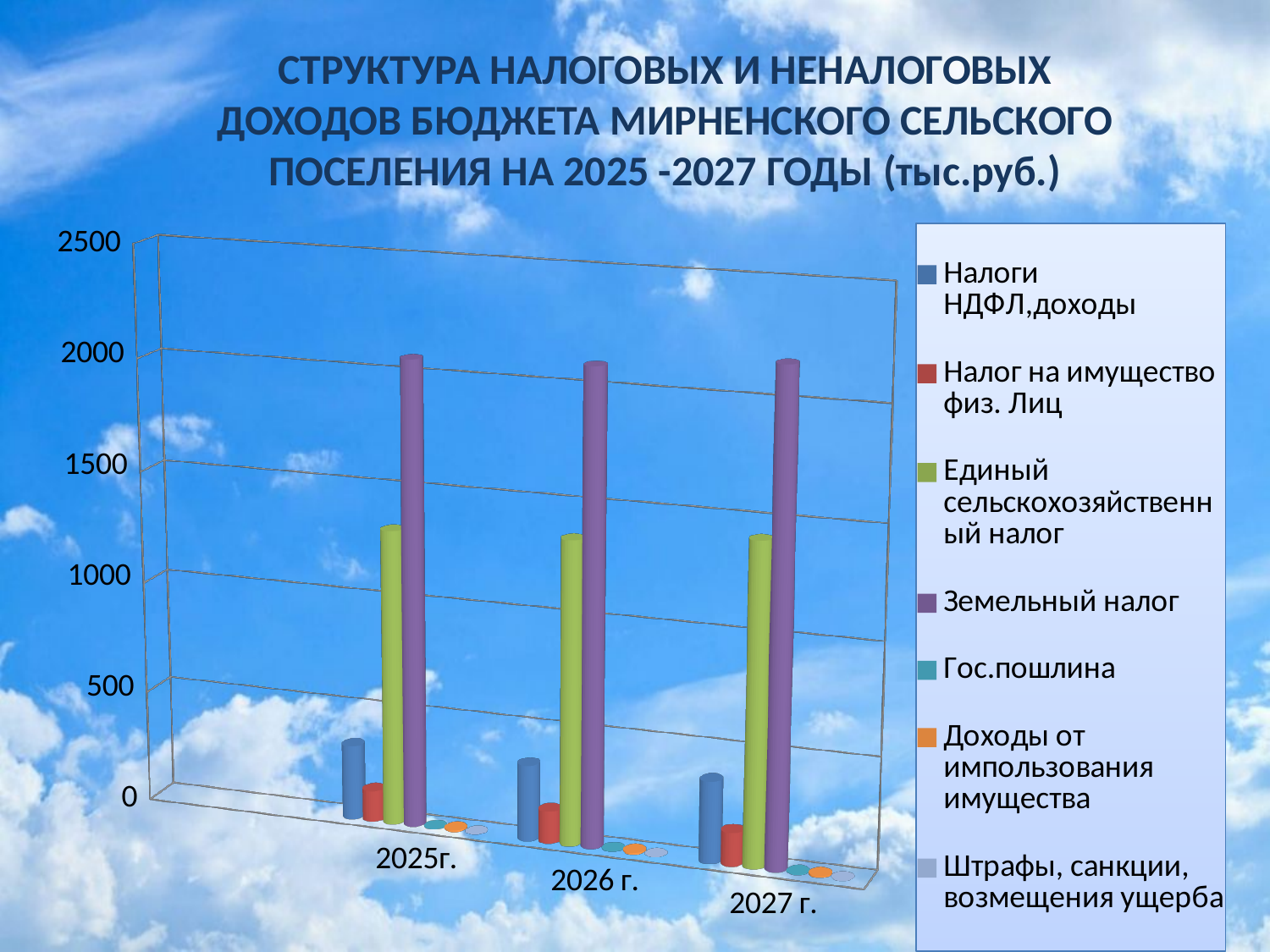
In 2026 г., which is larger: Земельный налог or Единый сельскохозяйственный налог? Земельный налог Is the value for Земельный налог in 2025г. greater or less than 1500? greater What kind of chart is shown on the slide? bar chart Is the value for Налоги НДФЛ,доходы in 2025г. greater or less than 500? less Which series has the highest value in 2027 г.? Земельный налог Is the value for Единый сельскохозяйственный налог in 2026 г. greater or less than 1000? greater How many year categories are shown on the x axis of the chart? 3 How many series does the chart legend list? 7 Which series has the highest value in 2025г.? Земельный налог Which colour represents Земельный налог in the chart legend? purple